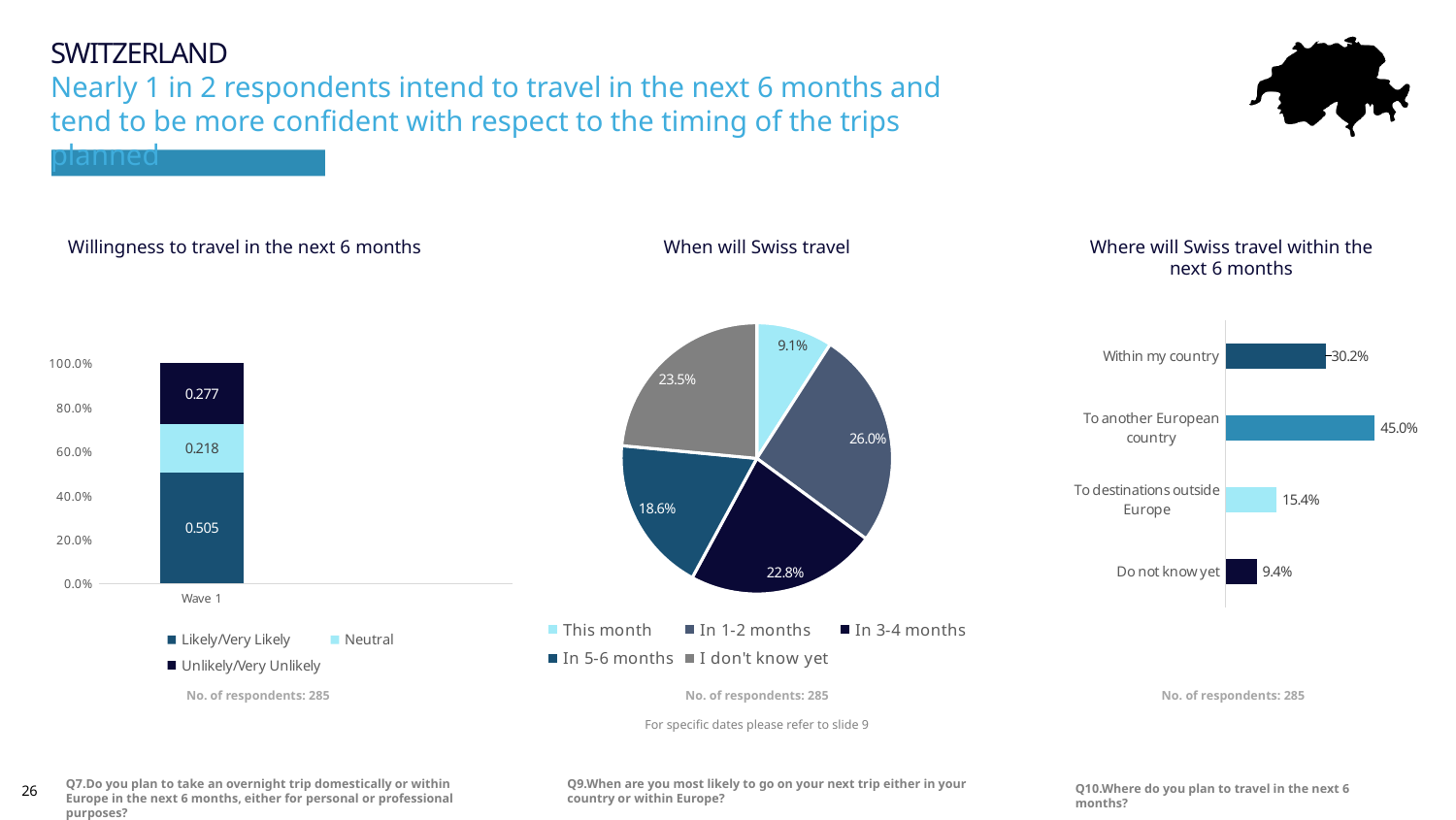
In the 'Where will Swiss travel within the next 6 months' chart, which category has the lowest value? Do not know yet In the 'Willingness to travel in the next 6 months' chart, which series has the largest value? Likely/Very Likely In the 'Willingness to travel in the next 6 months' chart, what is the difference between Unlikely/Very Unlikely and Neutral? 0.059 In the 'Willingness to travel in the next 6 months' chart, what is the value for Neutral? 0.218 In the 'Where will Swiss travel within the next 6 months' chart, what is the difference between 'Within my country' and 'To destinations outside Europe'? 14.8% In the 'When will Swiss travel' chart, what share of respondents plan to travel in 1-2 months? 26.0% In the 'When will Swiss travel' chart, what share of respondents plan to travel this month? 9.1% In the 'Willingness to travel in the next 6 months' chart, how many series does the legend list? 3 What kind of chart is 'When will Swiss travel'? Pie chart In the 'Where will Swiss travel within the next 6 months' chart, what is the value for 'To another European country'? 45.0% In the 'When will Swiss travel' chart, which category has the smallest slice? This month In the 'Willingness to travel in the next 6 months' chart, what is the value for Likely/Very Likely in Wave 1? 0.505